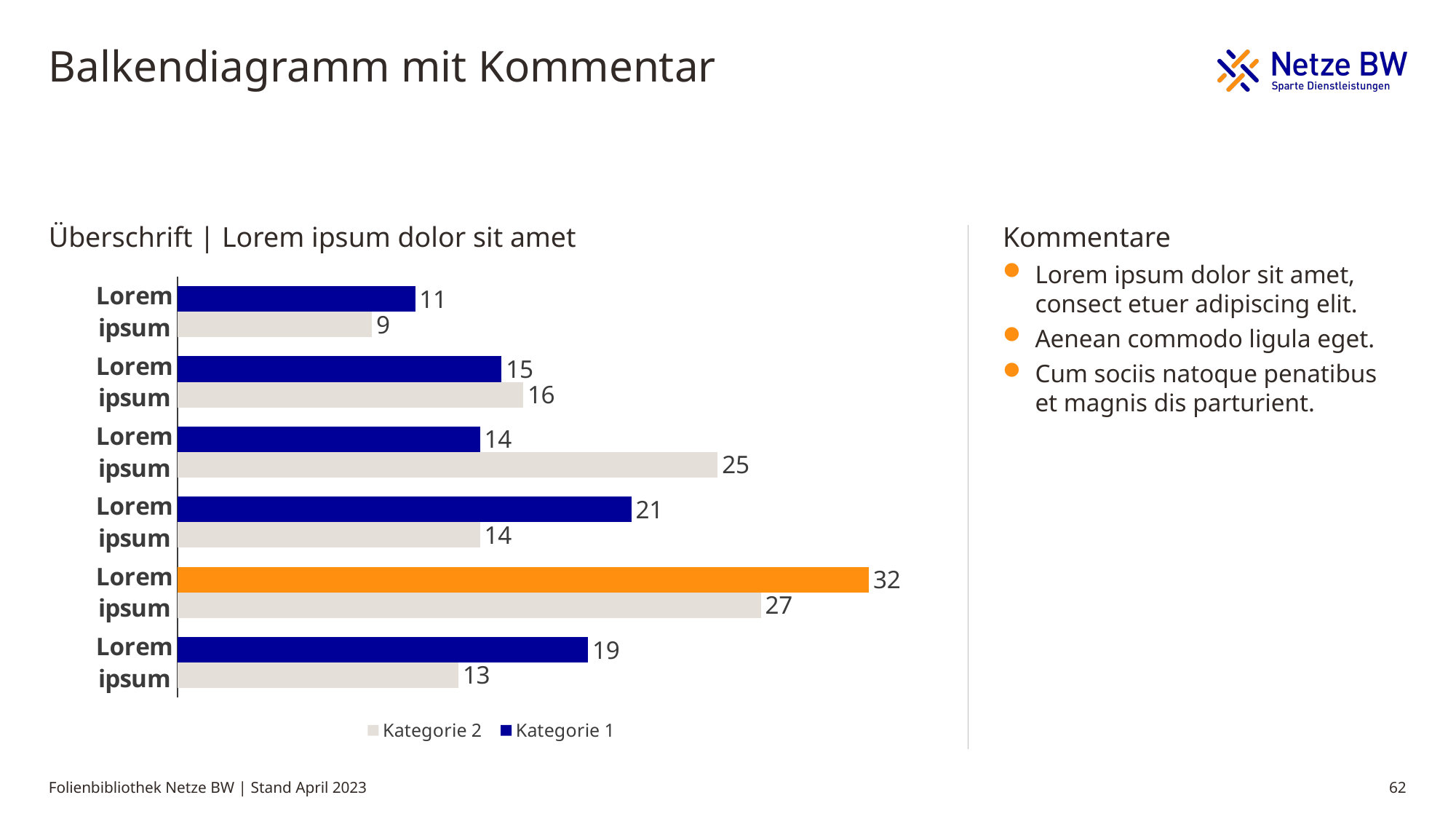
What is the title shown above the chart? Überschrift | Lorem ipsum dolor sit amet What is the lowest value shown on the chart? 9 What type of chart is shown on the slide? bar chart What is the difference between the Kategorie 1 and Kategorie 2 values for the fifth category from the top? 5 What is the Kategorie 2 value for the bottom category? 13 For the third category from the top, which is larger: Kategorie 1 or Kategorie 2? Kategorie 2 Which series has the highest value on the chart, and what is it? Kategorie 1, 32 What is the Kategorie 2 value for the third category from the top? 25 What is the Kategorie 1 value for the topmost category? 11 How many categories are plotted on the chart? 6 How many series does the chart legend list? 2 What colour is the highlighted Kategorie 1 bar with the value 32? orange